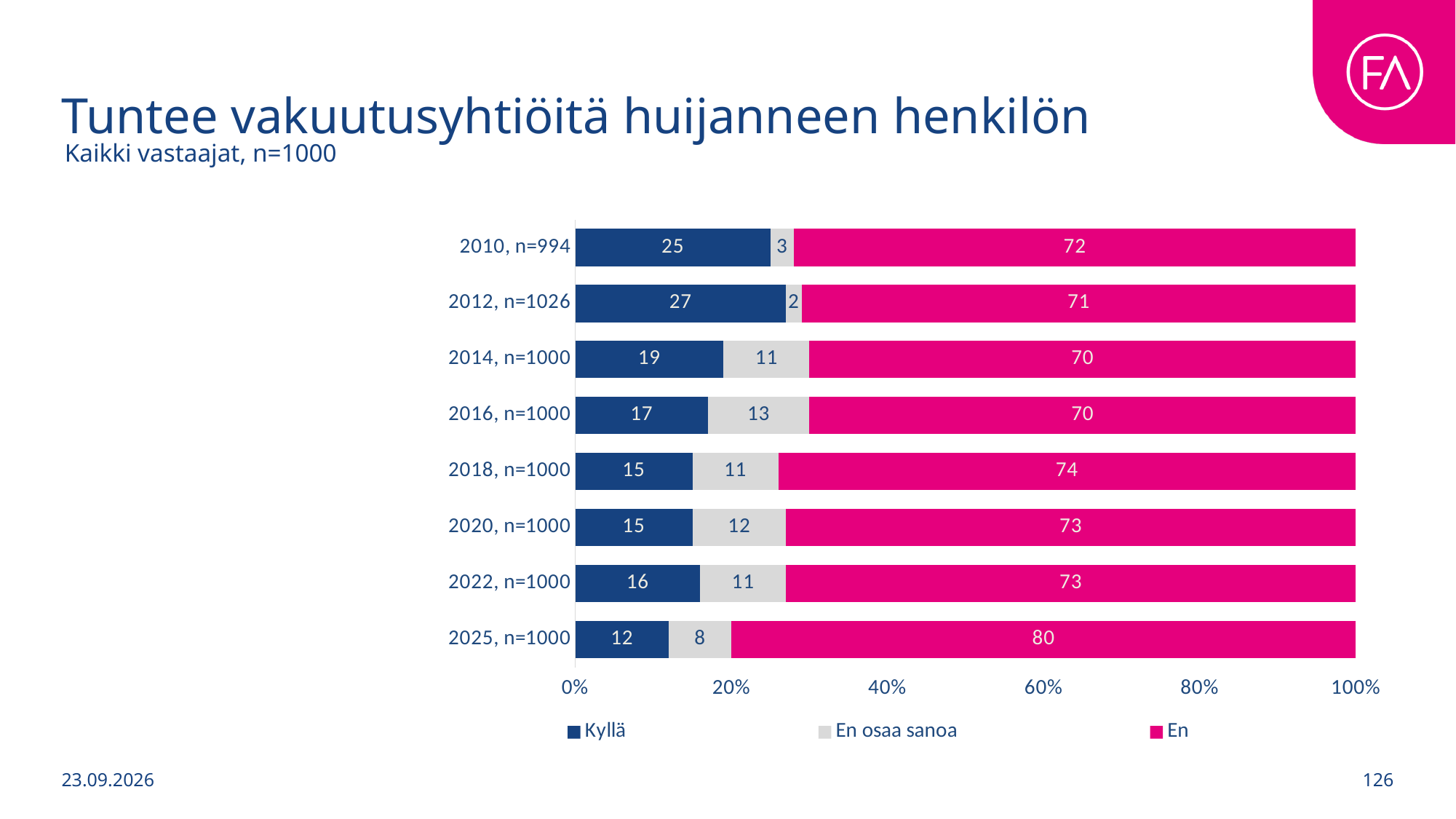
What is the value of "En" for "2018, n=1000"? 74 What is the title of the chart? Tuntee vakuutusyhtiöitä huijanneen henkilön What is the difference between the "Kyllä" values for "2012, n=1026" and "2025, n=1000"? 15 How many series does the legend list? 3 How many categories are shown on the chart? 8 What is the total of the stacked bar for "2020, n=1000"? 100 What kind of chart is shown on the slide? Stacked bar chart Which category has the lowest "Kyllä" value? 2025, n=1000 What is the value of "En osaa sanoa" for "2016, n=1000"? 13 What is the value of "Kyllä" for "2025, n=1000"? 12 Which category has the highest "En" value? 2025, n=1000 Which is larger: the "En osaa sanoa" value for "2014, n=1000" or for "2010, n=994"? 2014, n=1000